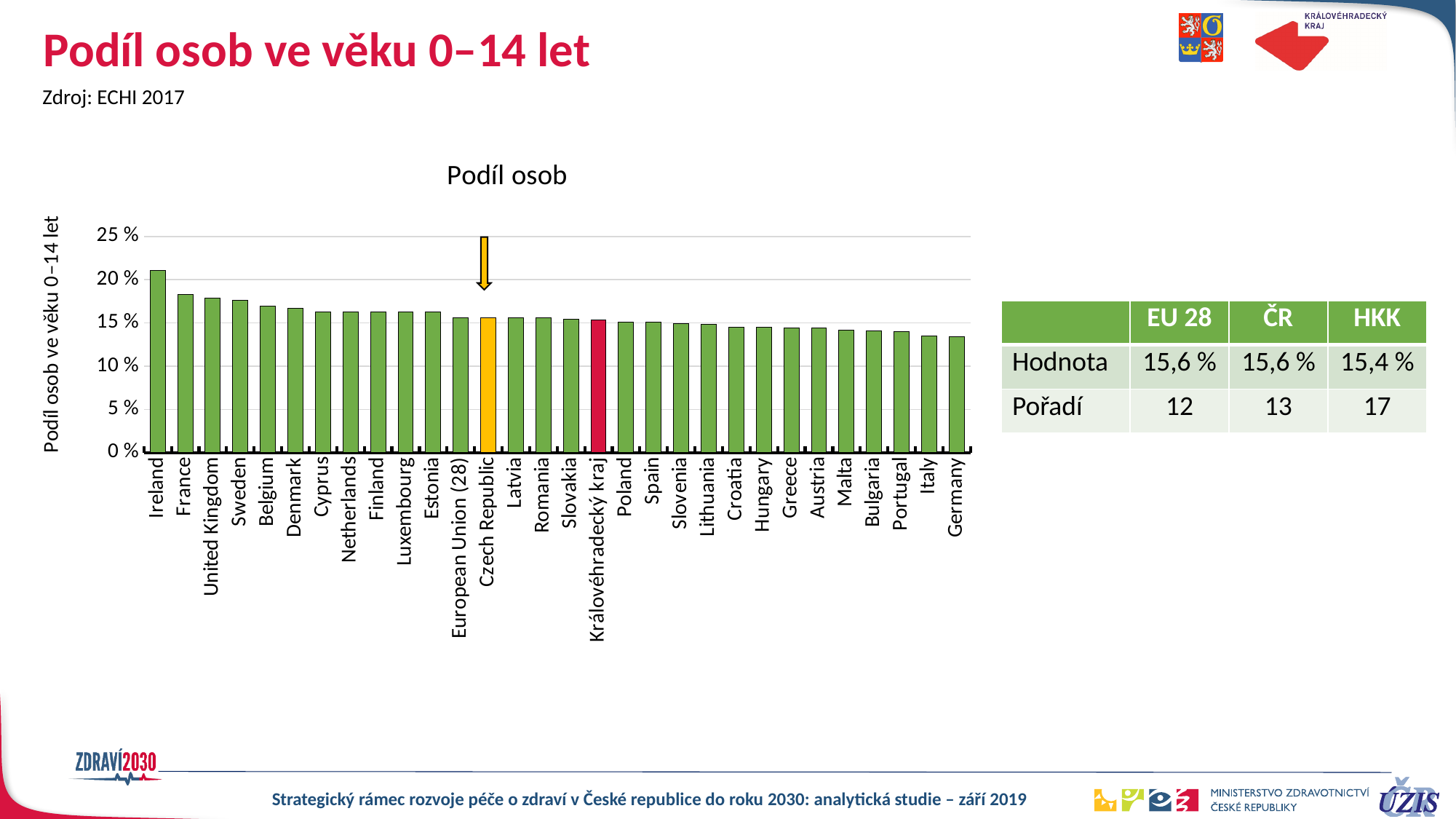
How many countries/regions are plotted on the x axis of the chart? 30 What is the difference between the values for Czech Republic and Královéhradecký kraj? 0,2 % What is the title of the chart? Podíl osob What is the value for Czech Republic? 15,6 % Do the values rise or fall from left to right along the x axis? fall Which is larger, the value for Czech Republic or for Královéhradecký kraj? Czech Republic What is the value for European Union (28)? 15,6 % What kind of chart is shown on the slide? bar chart Is the value for Germany greater or less than 15 %? less What is the value for Královéhradecký kraj? 15,4 % Is the value for Ireland greater or less than 20 %? greater Which category has the highest value in the chart? Ireland